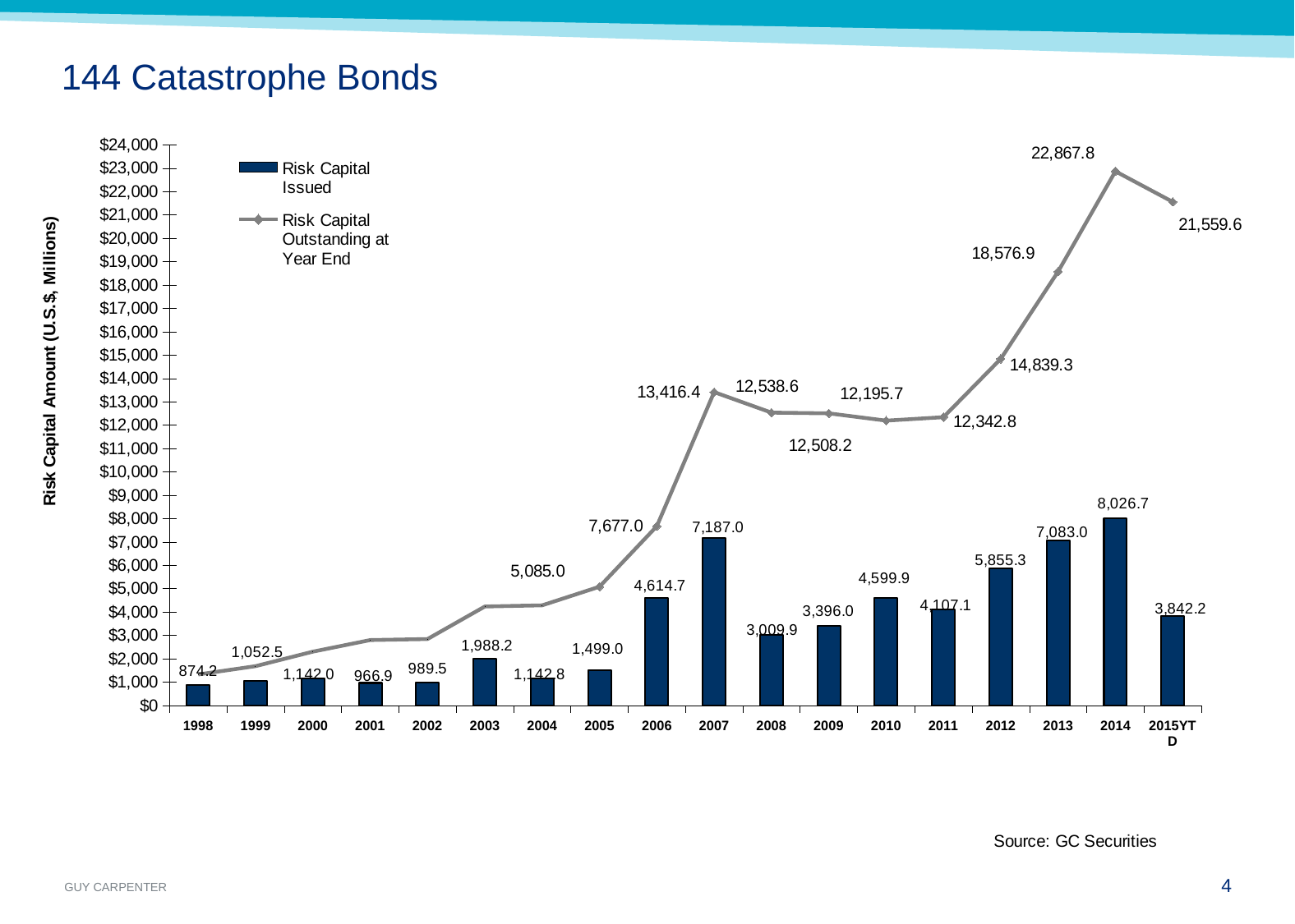
Is the Risk Capital Outstanding at Year End for 2003 greater or less than $5,000? less How many years (categories) are shown on the x axis? 18 In which year was Risk Capital Issued the highest? 2014 In which year was Risk Capital Issued the lowest? 1998 How many series does the legend list? 2 What was the Risk Capital Outstanding at Year End in 2014? 22,867.8 Which year had higher Risk Capital Issued, 2012 or 2013? 2013 What is the difference between Risk Capital Issued in 2014 and in 2013? 943.7 In which year was Risk Capital Outstanding at Year End the highest? 2014 What was the Risk Capital Issued in 2007? 7,187.0 Does Risk Capital Outstanding at Year End rise or fall from 2011 to 2014? rise What kind of chart is shown on the slide? Combination bar and line chart